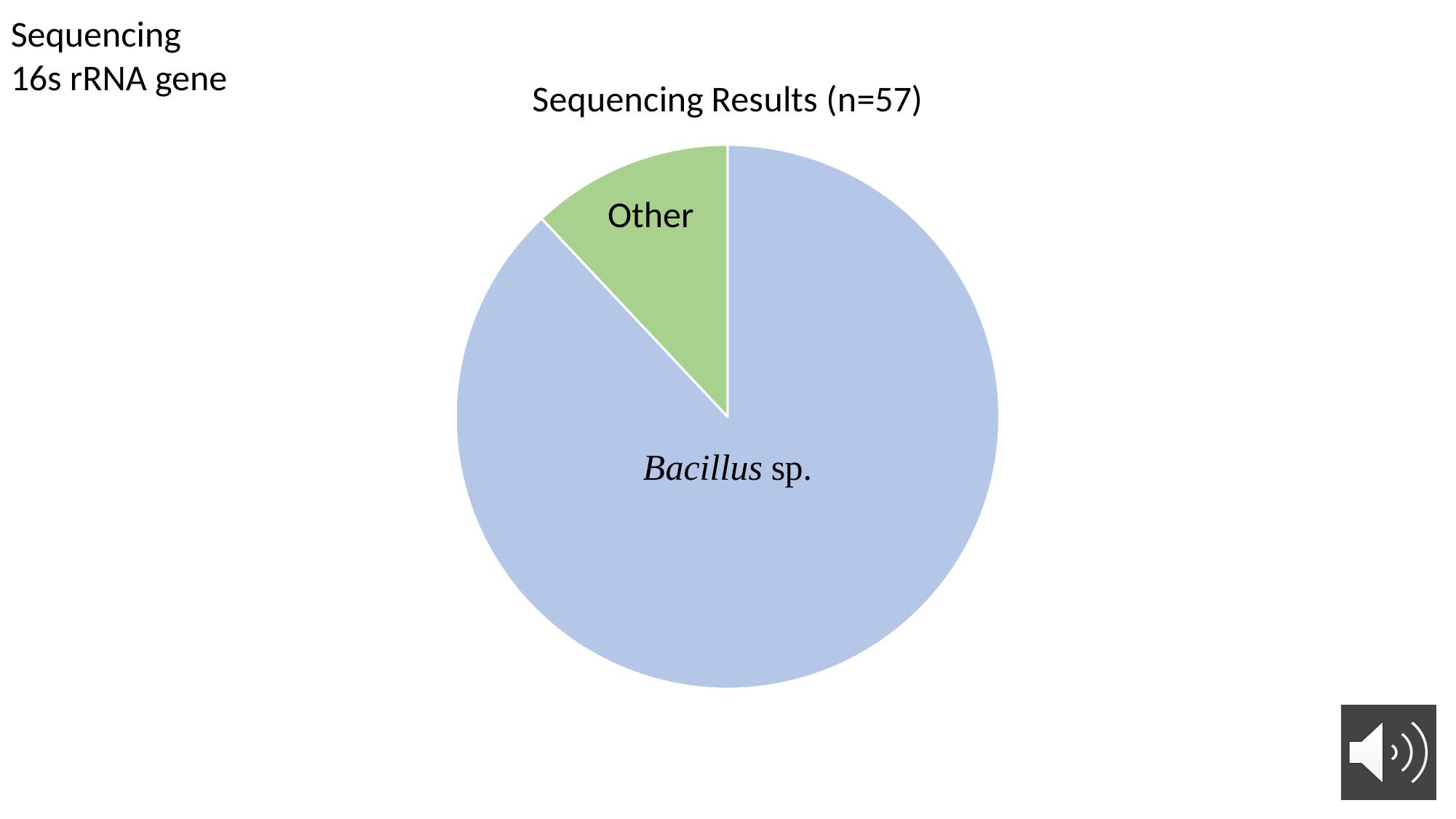
Which slice of the pie chart is the largest? Bacillus sp. What kind of chart is shown on the slide? pie chart Which slice of the pie chart is the smallest? Other How many slices does the pie chart have? 2 What colour is the Other slice? green What is the total sample size stated in the chart title? 57 What is the title of the chart? Sequencing Results (n=57) Which slice is larger, Bacillus sp. or Other? Bacillus sp.